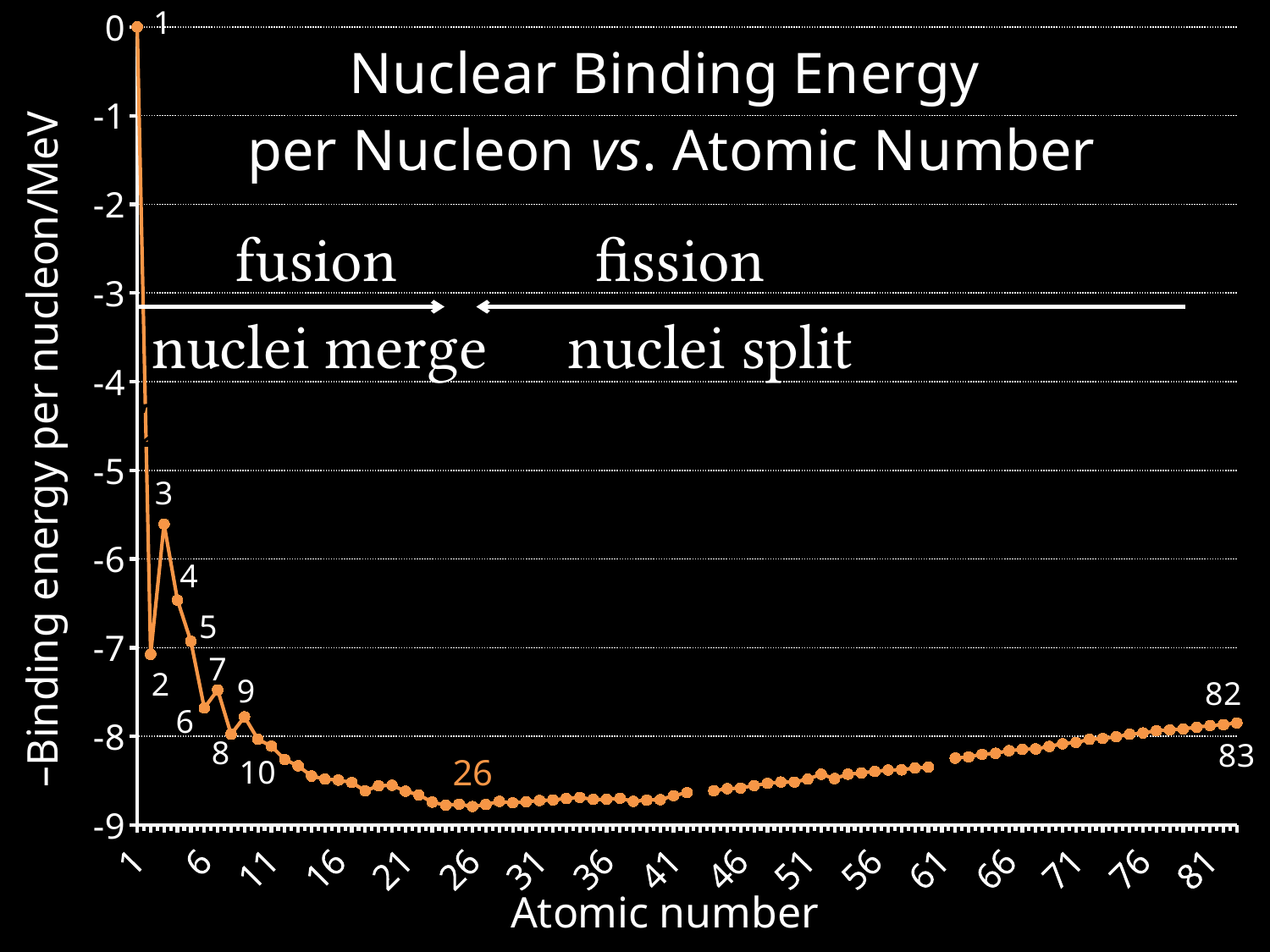
Is the value for atomic number 82 greater or less than -8? greater Do the plotted values rise or fall as the atomic number increases from 26 to 83? rise Which labelled atomic number has the highest plotted value? 1 Which has the higher plotted value, atomic number 3 or atomic number 4? atomic number 3 What kind of chart is shown on the slide? line chart What is the label of the x axis? Atomic number Which labelled atomic number has the lowest plotted value? 26 Is the value for atomic number 3 greater or less than -6? greater What is the title of the chart? Nuclear Binding Energy per Nucleon vs. Atomic Number Is the value for atomic number 26 greater or less than -8? less What is the binding energy per nucleon value plotted for atomic number 1? 0